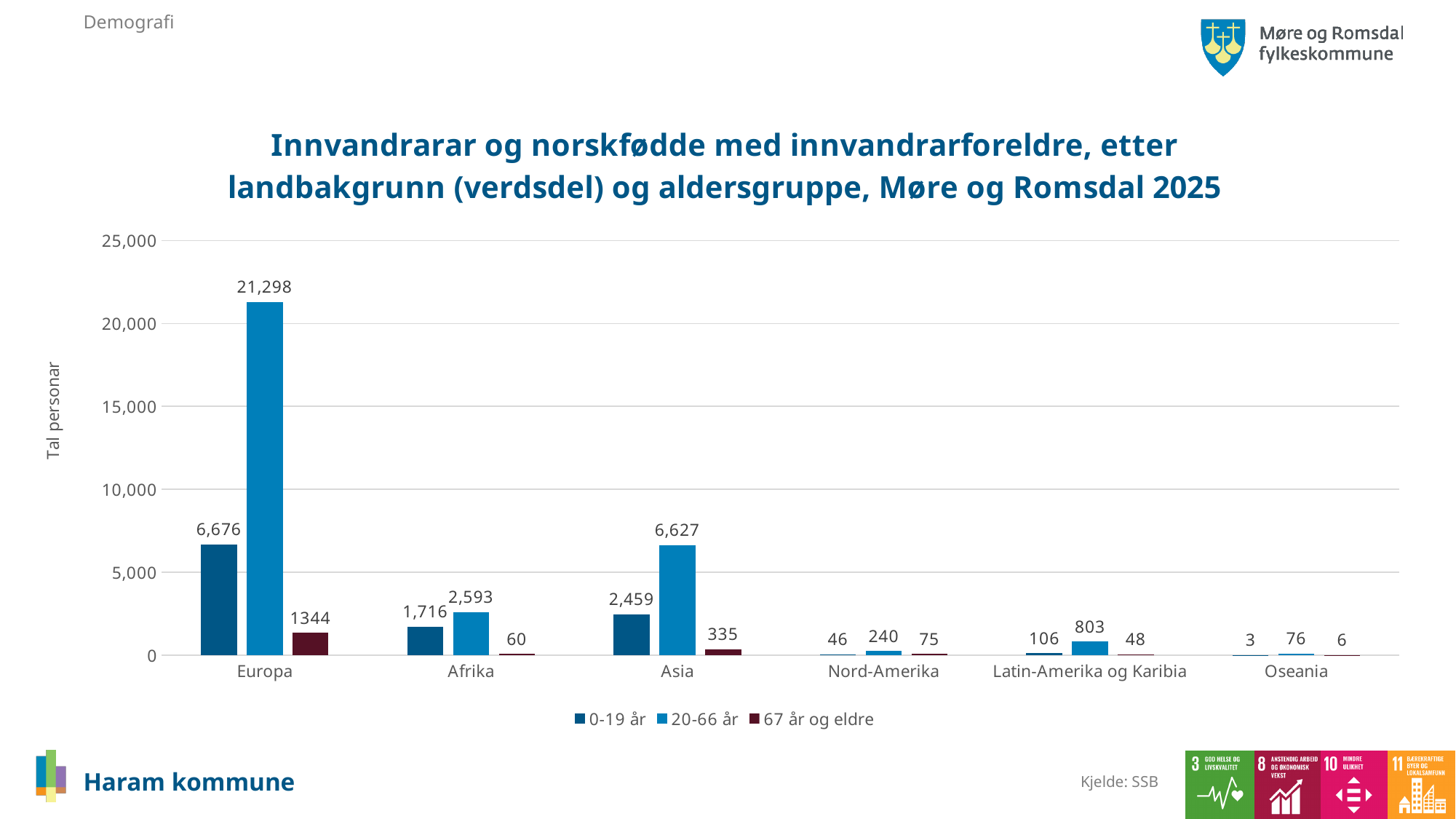
How many categories are shown on the x axis? 6 What is the value for the 67 år og eldre series for Asia? 335 What kind of chart is shown on the slide? bar chart Which category has the lowest value in the 0-19 år series? Oseania What is the value for the 20-66 år series for Europa? 21,298 Which is larger: the 0-19 år value for Afrika or the 0-19 år value for Asia? Asia How many series does the legend list? 3 What is the difference between the 20-66 år value and the 0-19 år value for Asia? 4,168 What is the value for the 0-19 år series for Latin-Amerika og Karibia? 106 Is the value for the 20-66 år series for Europa greater or less than 20,000? greater What is the label of the y axis? Tal personar Which category has the highest value in the 20-66 år series? Europa